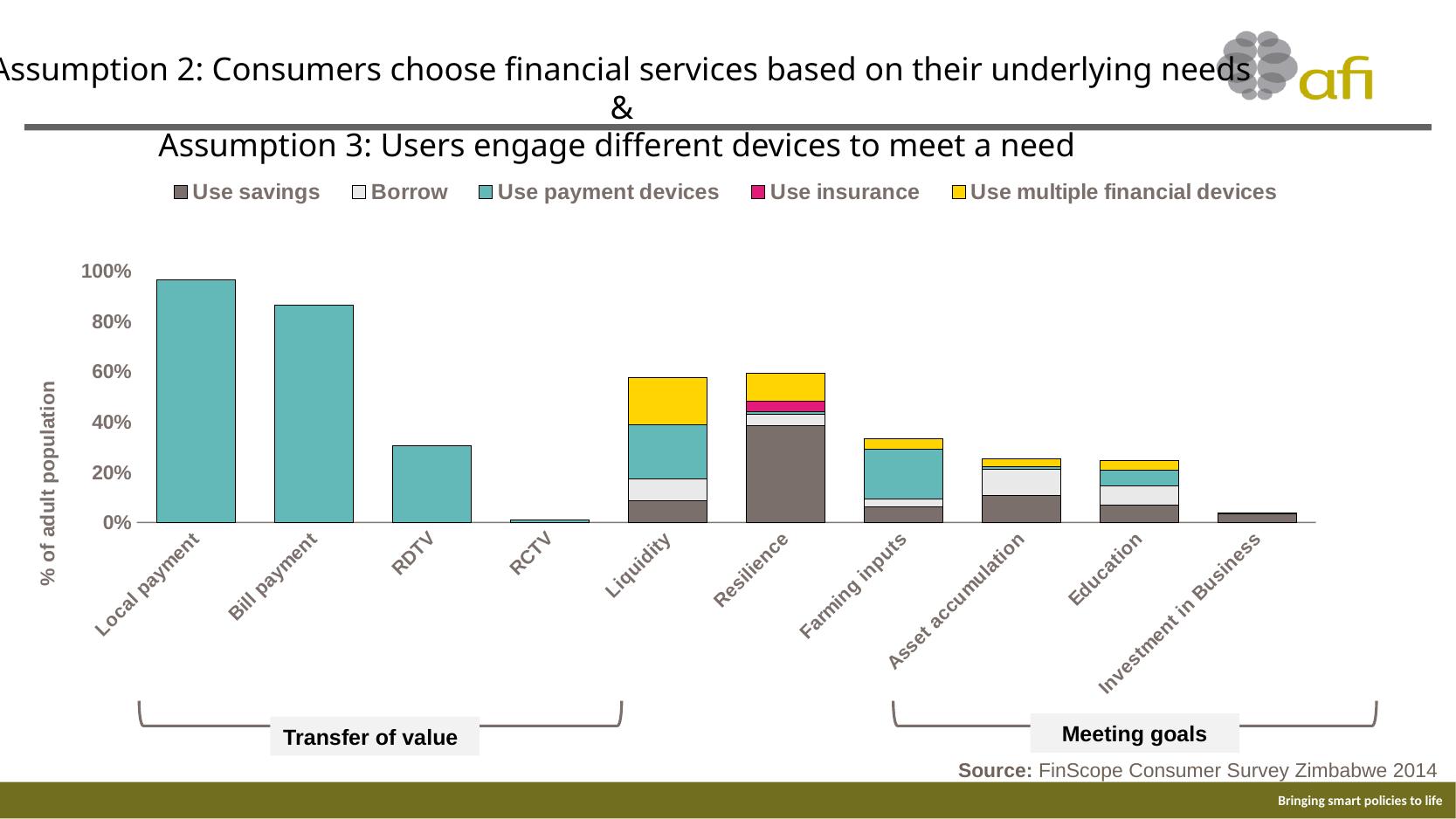
What is the label on the chart's y axis? % of adult population Which category has the lowest total bar? RCTV How many categories are shown along the x axis of the chart? 10 Is the value for Investment in Business greater or less than 20%? less Which has a taller total bar, Farming inputs or Asset accumulation? Farming inputs Is the total value for Liquidity greater or less than 40%? greater Is the value for RDTV greater or less than 40%? less Which category has the highest total bar? Local payment Which has a taller bar, Local payment or Bill payment? Local payment What kind of chart is shown on the slide? Stacked bar chart How many series does the chart's legend list? 5